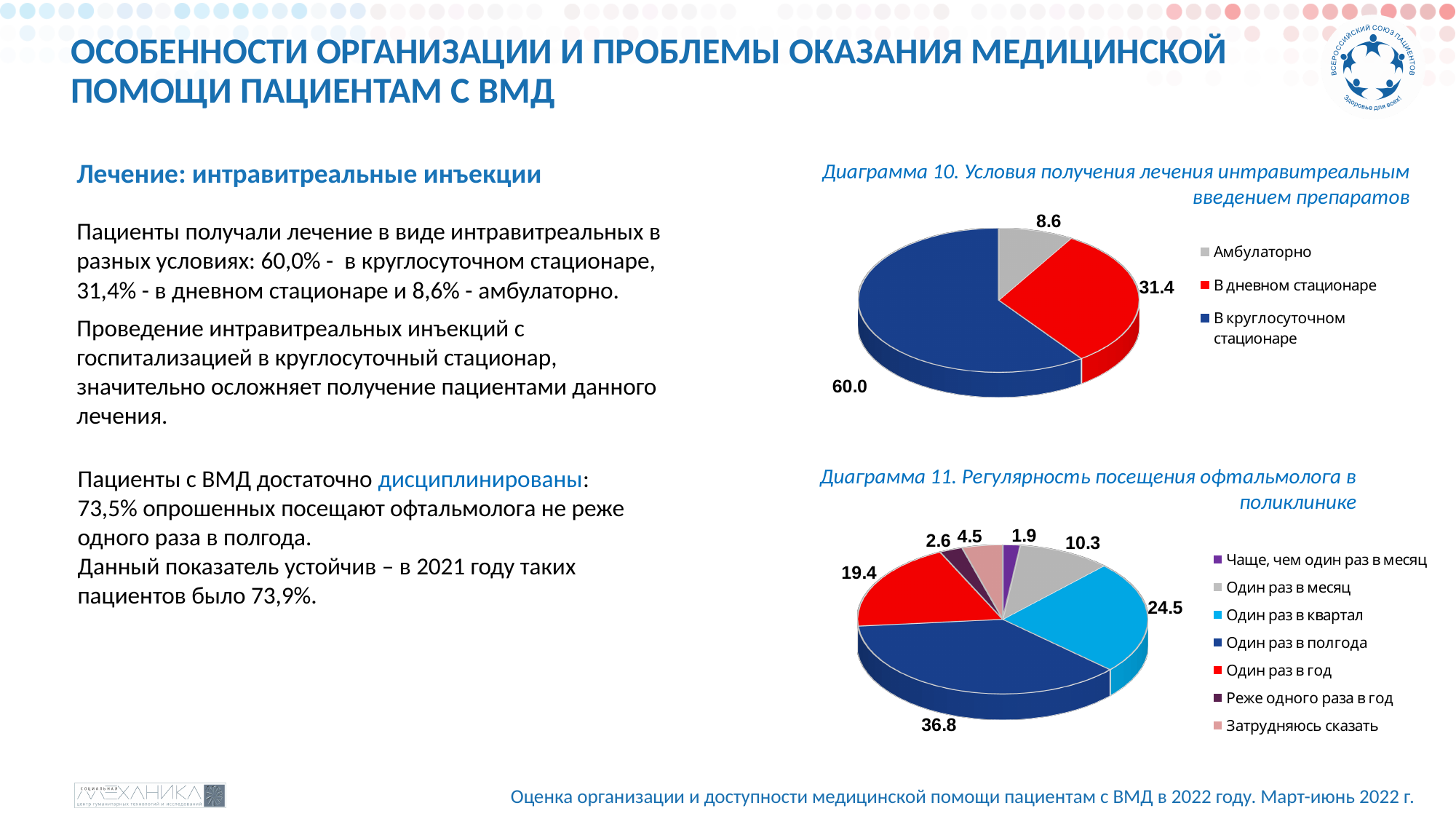
In Диаграмма 11, what is the difference between «Один раз в год» and «Реже одного раза в год»? 16.8 In Диаграмма 10, what is the difference between «В круглосуточном стационаре» and «В дневном стационаре»? 28.6 In Диаграмма 10, what is the value for «В дневном стационаре»? 31.4 What kind of chart is Диаграмма 10? Pie chart In Диаграмма 10, which category has the largest share? В круглосуточном стационаре How many categories does the legend of Диаграмма 10 list? 3 In Диаграмма 11, what is the value for «Один раз в квартал»? 24.5 In Диаграмма 11, what is the value for «Один раз в полгода»? 36.8 In Диаграмма 10, what is the value for «Амбулаторно»? 8.6 In Диаграмма 11, which category has the smallest share? Чаще, чем один раз в месяц How many categories does the legend of Диаграмма 11 list? 7 In Диаграмма 11, which is larger: «Один раз в год» or «Один раз в месяц»? Один раз в год